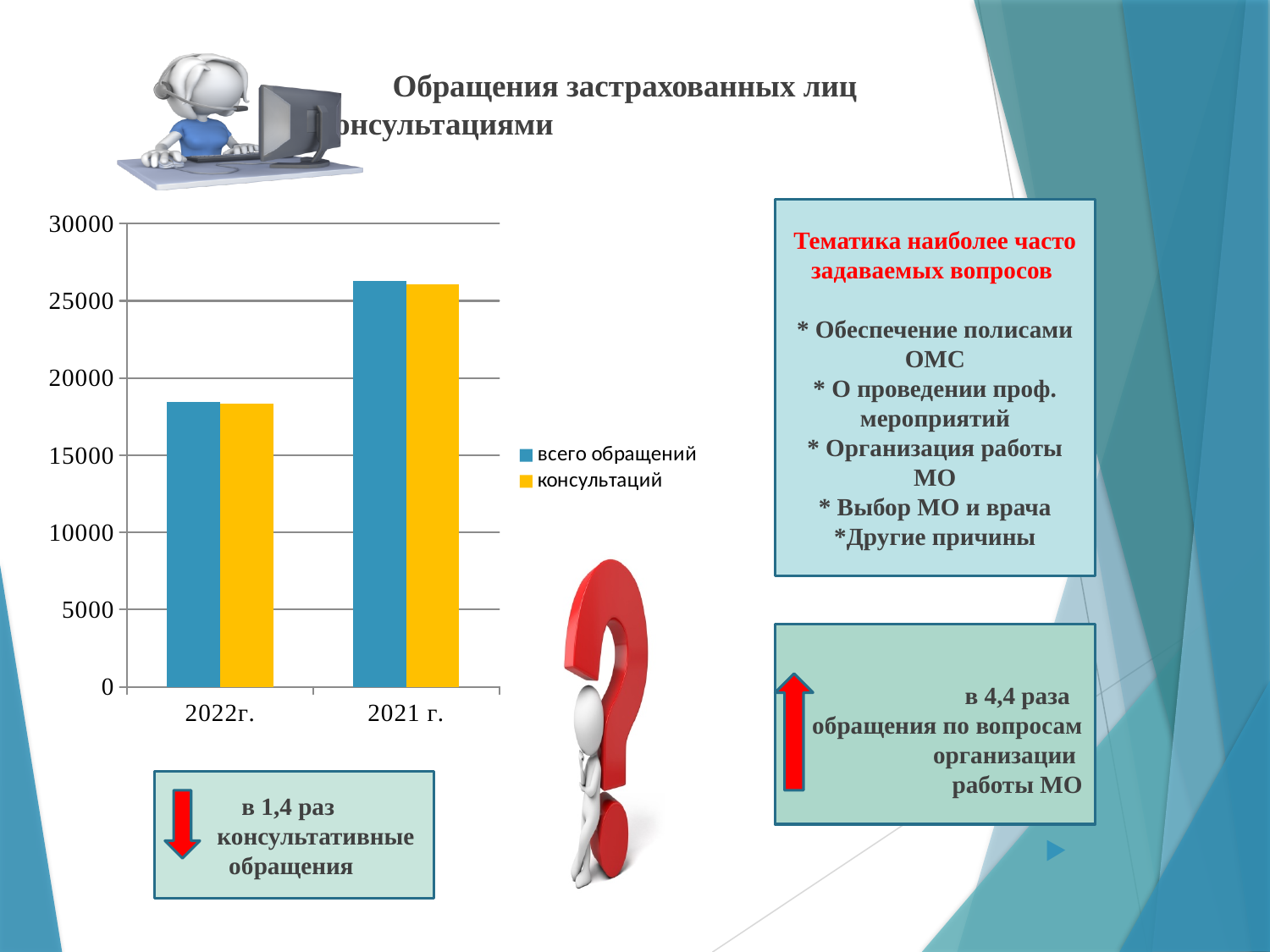
Do the values for всего обращений rise or fall moving from 2022г. to 2021 г. along the x axis? rise Is the value for всего обращений in 2021 г. greater or less than 25000? greater Which colour represents the series консультаций in the chart? yellow Is the value for всего обращений in 2022г. greater or less than 15000? greater What kind of chart is shown on the slide? bar chart Which category has the lowest value for консультаций? 2022г. What are the two series listed in the chart legend? всего обращений, консультаций Which category has the higher value for всего обращений, 2022г. or 2021 г.? 2021 г. Is the value for всего обращений in 2022г. greater or less than 20000? less How many categories are shown on the x axis of the chart? 2 How many series does the chart legend list? 2